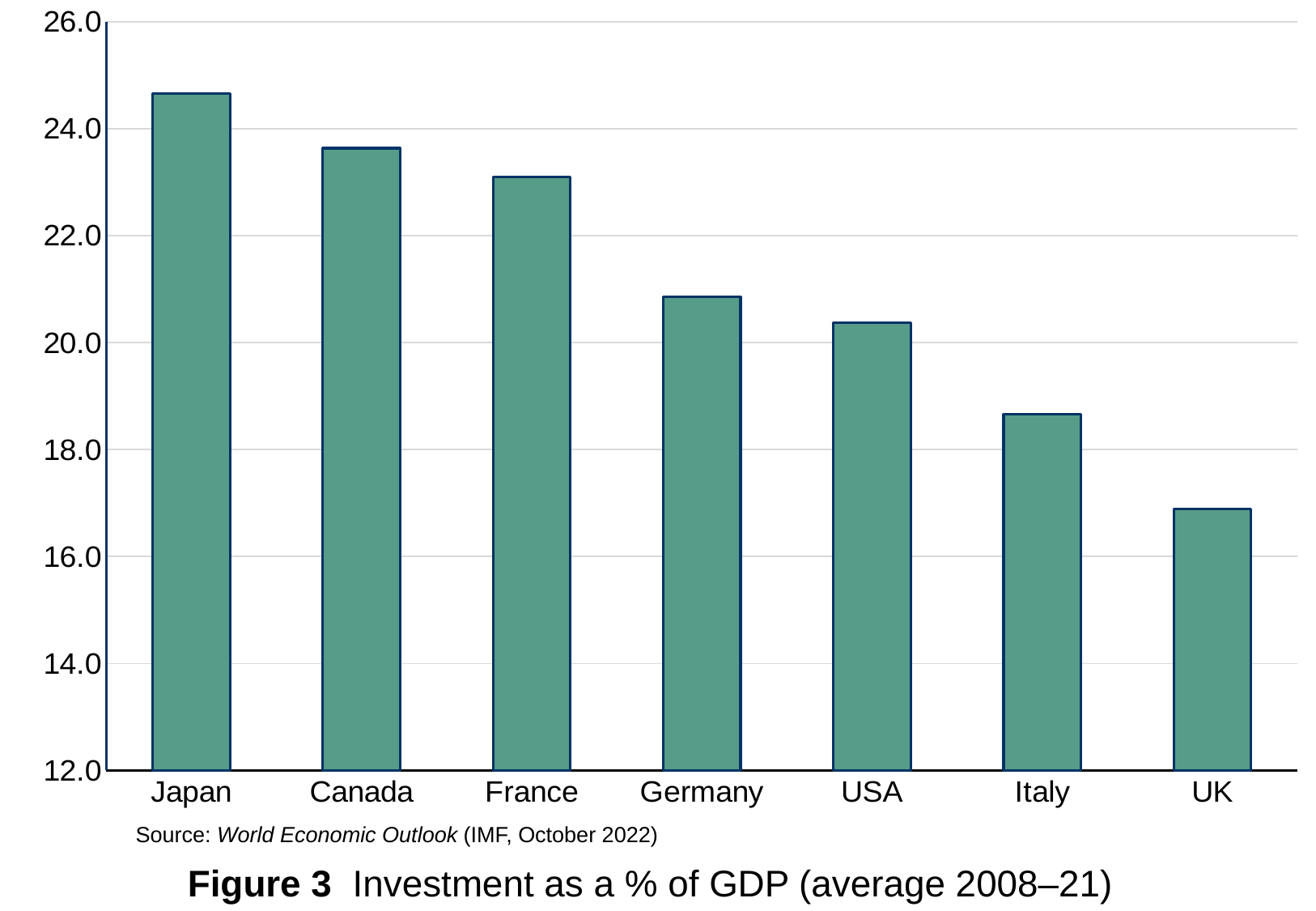
How many countries are shown on the chart? 7 Is the value for Japan greater or less than 24.0? greater Which is larger, the value for Canada or the value for France? Canada Do the values rise or fall moving from left to right across the countries? fall What kind of chart is shown in Figure 3? bar chart Is the value for UK greater or less than 18.0? less Which is larger, the value for USA or the value for Italy? USA Is the value for Italy greater or less than 20.0? less Which country has the highest investment as a % of GDP? Japan Which country has the lowest investment as a % of GDP? UK What is the source cited for the chart? World Economic Outlook (IMF, October 2022)